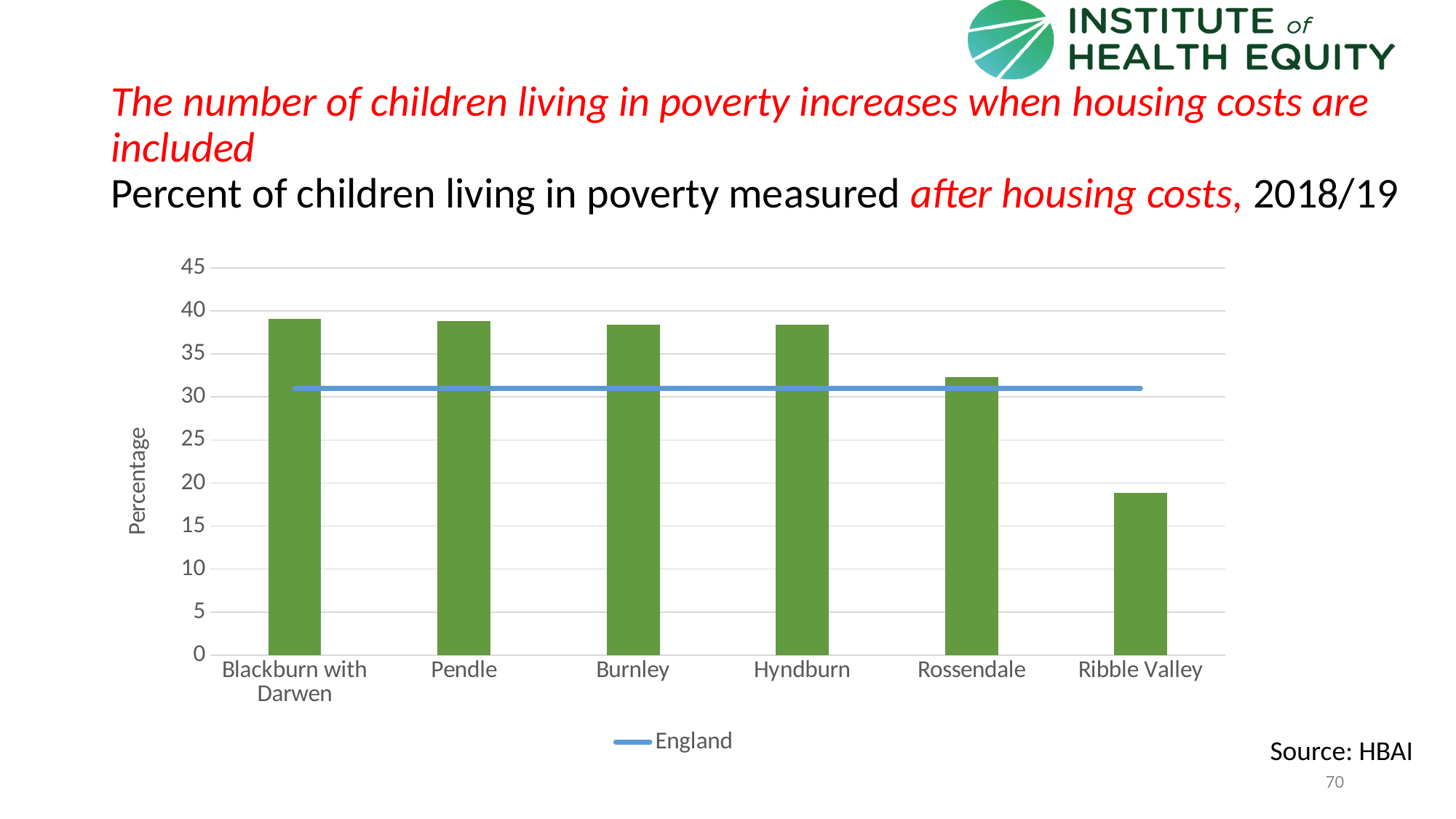
Is the value for Rossendale greater or less than 30? greater What kind of chart is shown on the slide? Combination bar and line chart How many local authority categories are shown on the x axis? 6 Is the value for Blackburn with Darwen greater or less than 35? greater Which has a higher value, Hyndburn or Rossendale? Hyndburn How many series does the legend list? 1 Is the value for Ribble Valley greater or less than 20? less Do the bar values generally rise or fall moving from left to right along the x axis? Fall Which has a higher value, Rossendale or Ribble Valley? Rossendale What is the label on the y axis? Percentage Which category has the lowest percentage of children living in poverty after housing costs? Ribble Valley